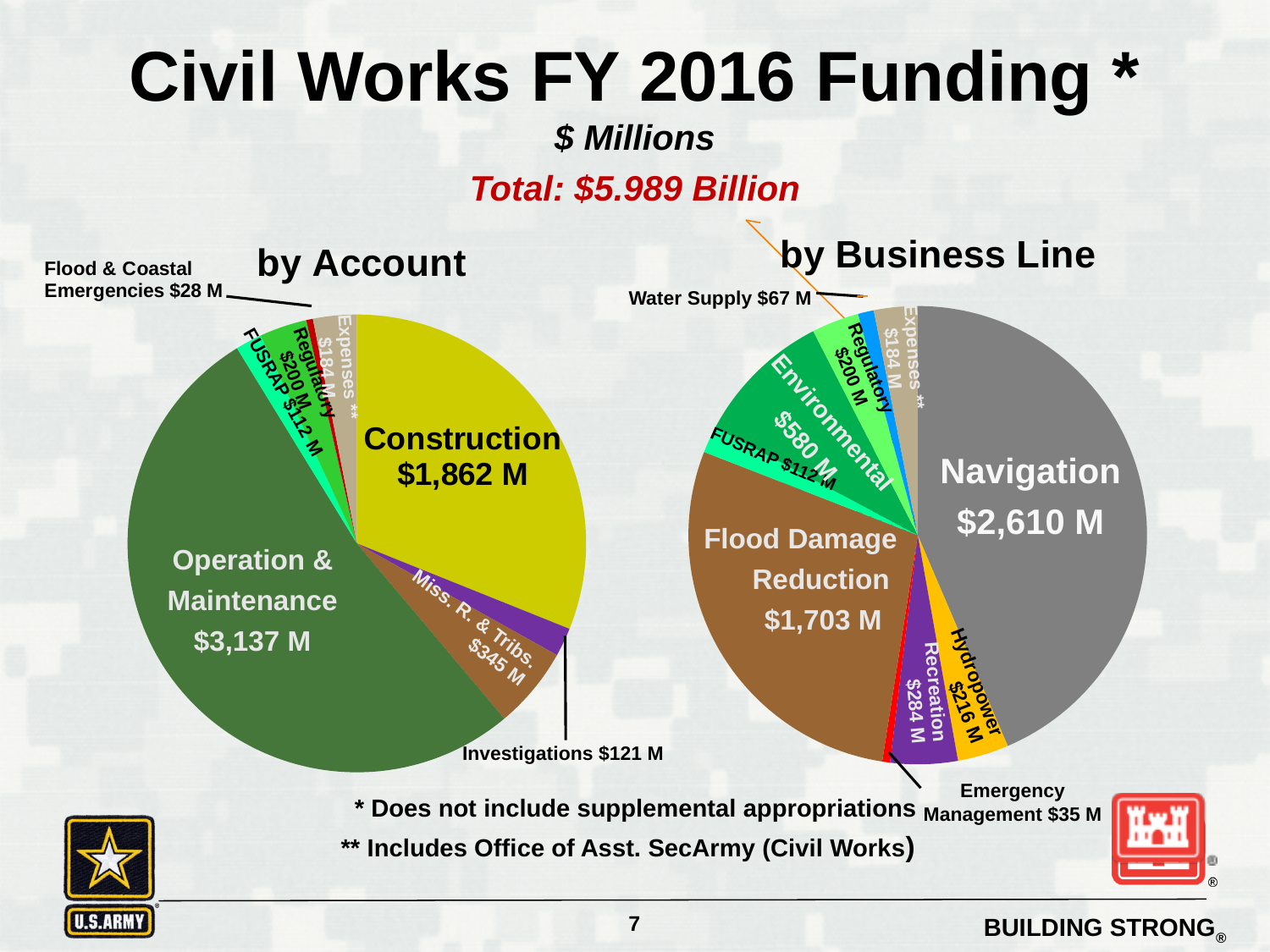
In the 'by Account' pie chart, how many slices are there? 8 In the 'by Business Line' pie chart, which business line has the largest slice? Navigation In the 'by Account' pie chart, what is the value for Investigations? $121 M In the 'by Business Line' pie chart, which is larger, Recreation or Hydropower? Recreation In the 'by Account' pie chart, what is the value for Construction? $1,862 M In the 'by Account' pie chart, what is the value for Operation & Maintenance? $3,137 M In the 'by Business Line' pie chart, what is the difference between Navigation and Flood Damage Reduction? $907 M In the 'by Business Line' pie chart, what is the value for Navigation? $2,610 M In the 'by Account' pie chart, which account has the smallest slice? Flood & Coastal Emergencies What type of chart is used on this slide? Pie chart In the 'by Account' pie chart, what is the difference between Operation & Maintenance and Construction? $1,275 M In the 'by Business Line' pie chart, what is the value for Flood Damage Reduction? $1,703 M